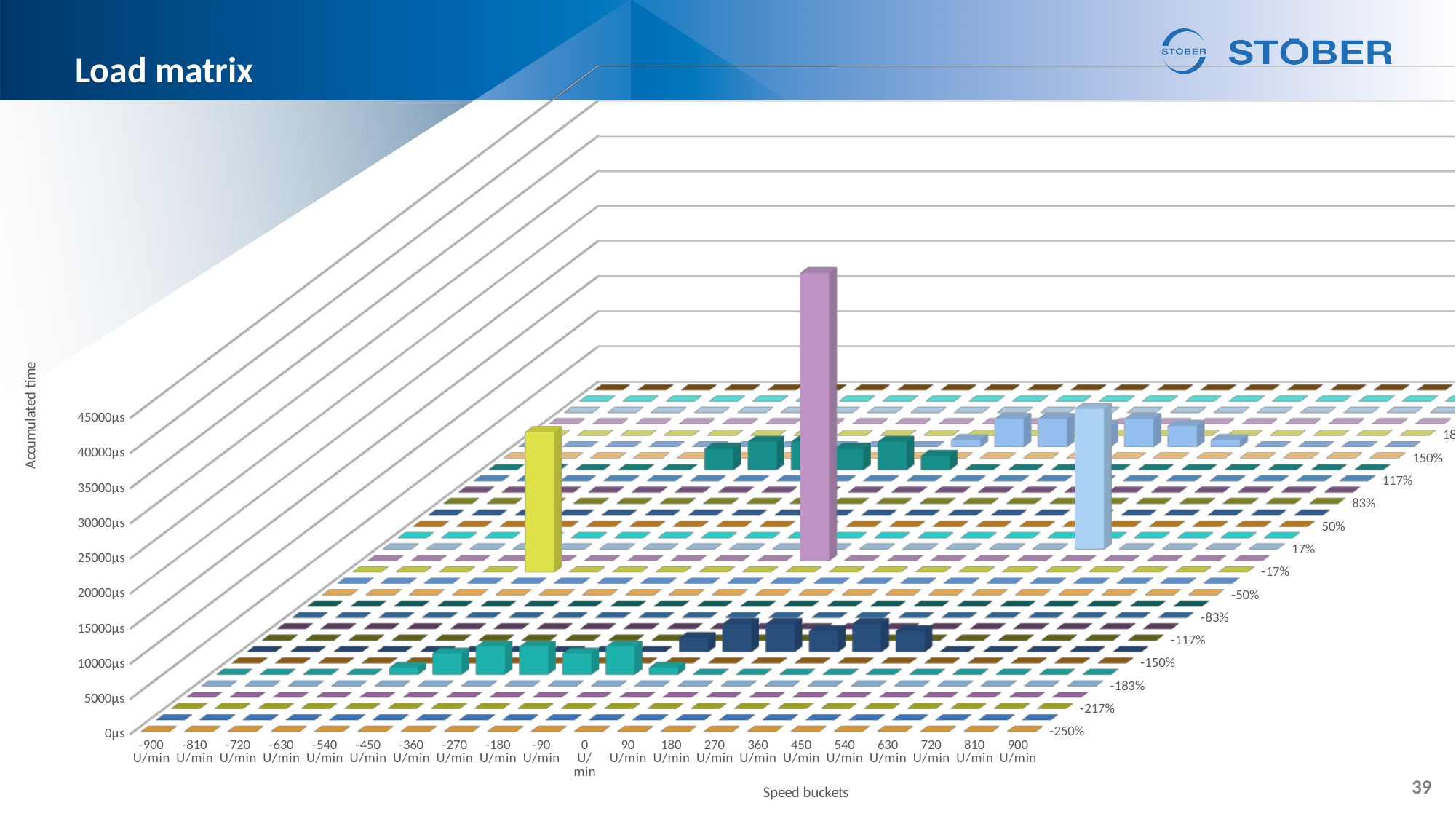
What is the lowest speed bucket label on the x axis? -900 U/min What is the lowest percentage label on the depth axis? -250% How many speed bucket categories are shown on the x axis? 21 What is the interval between consecutive ticks on the vertical axis? 5000µs Is the value of the yellow bar greater or less than 5000µs? greater Which is taller, the yellow bar or the pink bar? the pink bar What kind of chart is shown on the slide? bar chart Is the value of the tallest (pink) bar greater or less than 20000µs? greater